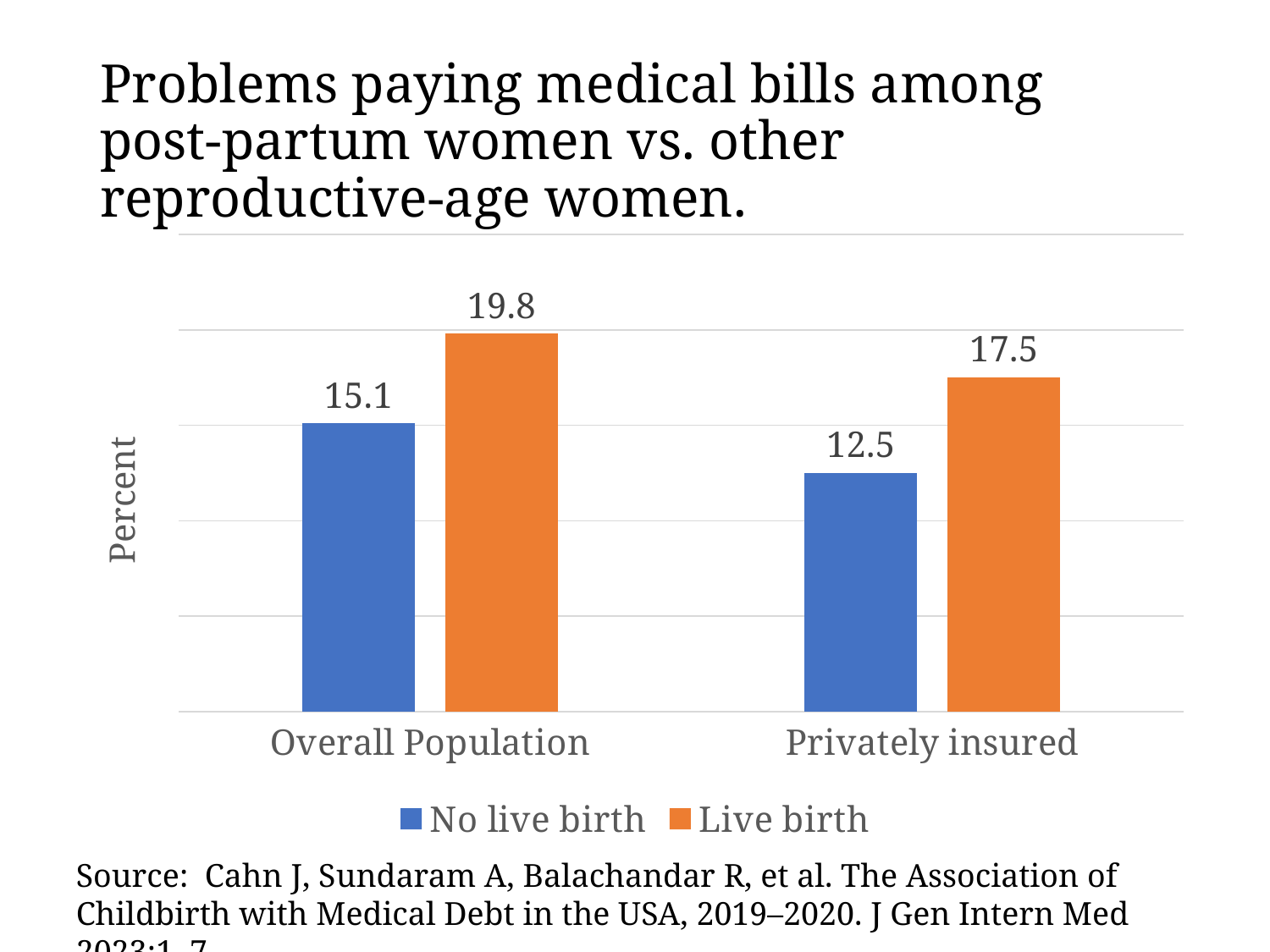
How many series does the legend list? 2 How many categories are shown on the x axis? 2 Which bar has the lowest value on the chart? No live birth, Privately insured In the Privately insured category, which is larger: Live birth or No live birth? Live birth What is the difference between the Live birth and No live birth values in the Overall Population category? 4.7 What is the difference between the Live birth and No live birth values in the Privately insured category? 5.0 What kind of chart is shown on the slide? Bar chart What is the value for Live birth in the Privately insured category? 17.5 What is the value for No live birth in the Overall Population category? 15.1 What is the value for No live birth in the Privately insured category? 12.5 What is the value for Live birth in the Overall Population category? 19.8 Which bar has the highest value on the chart? Live birth, Overall Population